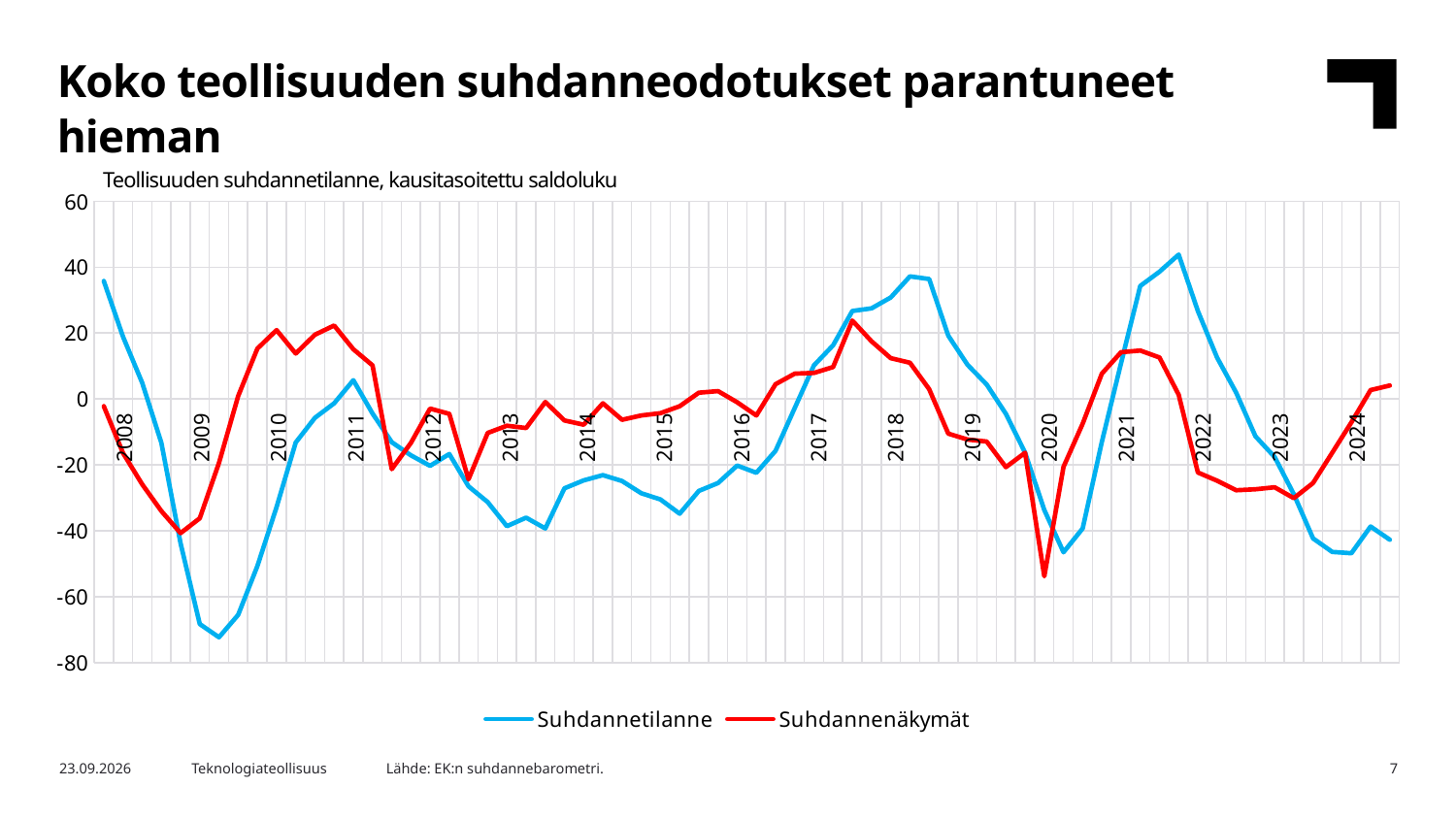
At the end of the chart in 2024, which series is higher, Suhdannetilanne or Suhdannenäkymät? Suhdannenäkymät Is the peak value of the Suhdannetilanne line around 2021 greater or less than 40? greater Is the value of the Suhdannenäkymät line at the end of 2024 greater or less than 0? greater Is the lowest value of the Suhdannetilanne line, around 2009, greater or less than -60? less Around 2009, which series has the higher value, Suhdannetilanne or Suhdannenäkymät? Suhdannenäkymät Does the Suhdannetilanne line rise or fall between its 2021 peak and 2023? fall How many year labels are shown on the x axis? 17 What is the subtitle printed above the chart? Teollisuuden suhdannetilanne, kausitasoitettu saldoluku What kind of chart is shown on the slide? line chart How many series does the legend list? 2 What are the two series named in the legend? Suhdannetilanne and Suhdannenäkymät